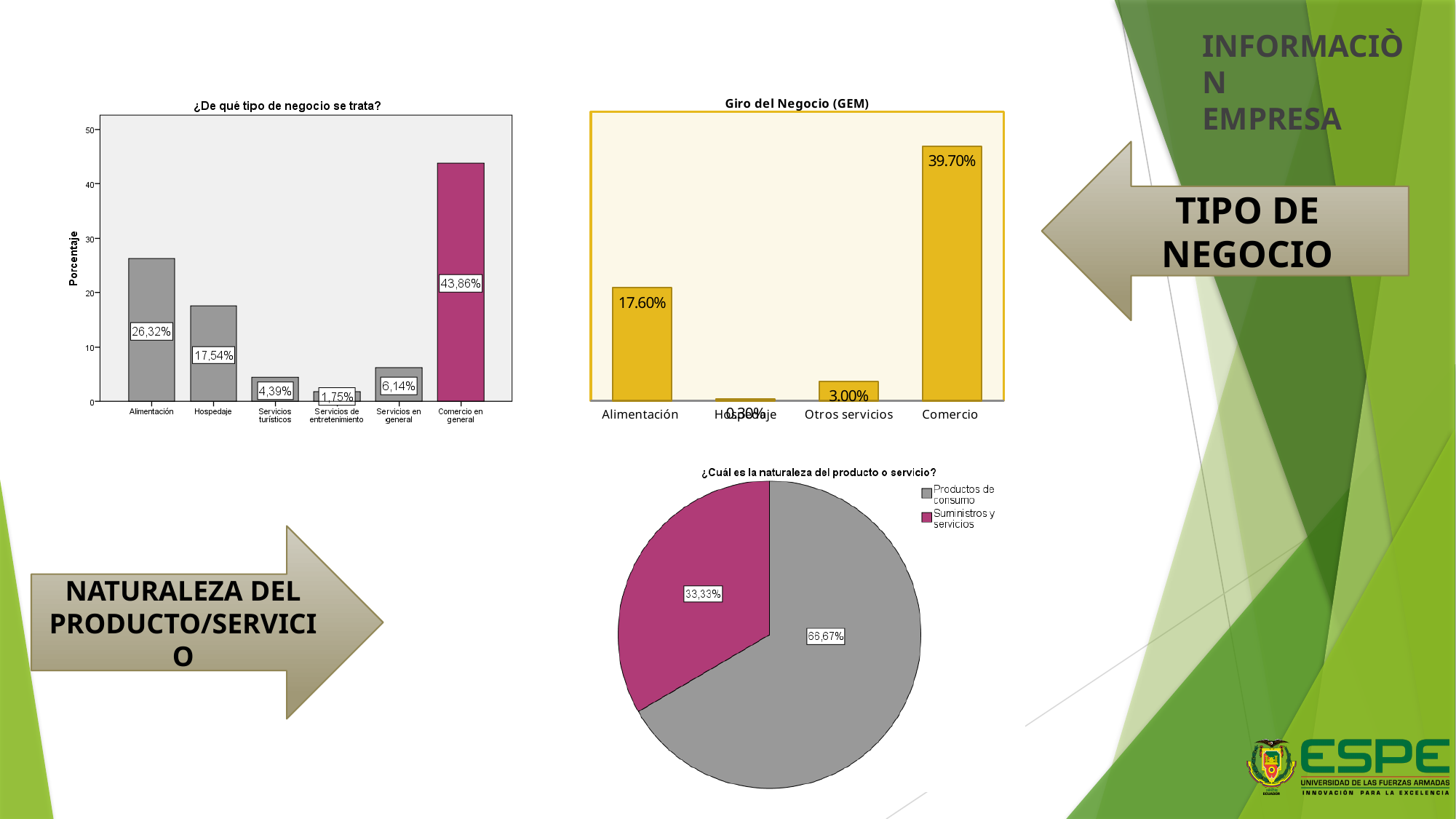
What kind of chart is the one titled '¿Cuál es la naturaleza del producto o servicio?'? Pie chart In the pie chart titled '¿Cuál es la naturaleza del producto o servicio?', what share is Productos de consumo? 66,67% In the chart titled '¿De qué tipo de negocio se trata?', which category has the lowest value? Servicios de entretenimiento In the chart titled 'Giro del Negocio (GEM)', what is the value for Comercio? 39.70% In the chart titled 'Giro del Negocio (GEM)', which category has the highest value? Comercio In the chart titled '¿De qué tipo de negocio se trata?', how many categories are shown on the x axis? 6 In the chart titled '¿De qué tipo de negocio se trata?', what is the difference between Alimentación and Hospedaje? 8,78% In the pie chart titled '¿Cuál es la naturaleza del producto o servicio?', how many entries does the legend list? 2 In the chart titled '¿De qué tipo de negocio se trata?', what is the value for Comercio en general? 43,86% In the chart titled 'Giro del Negocio (GEM)', what is the value for Alimentación? 17.60% In the chart titled 'Giro del Negocio (GEM)', which is larger, Alimentación or Otros servicios? Alimentación In the chart titled '¿De qué tipo de negocio se trata?', what is the value for Hospedaje? 17,54%